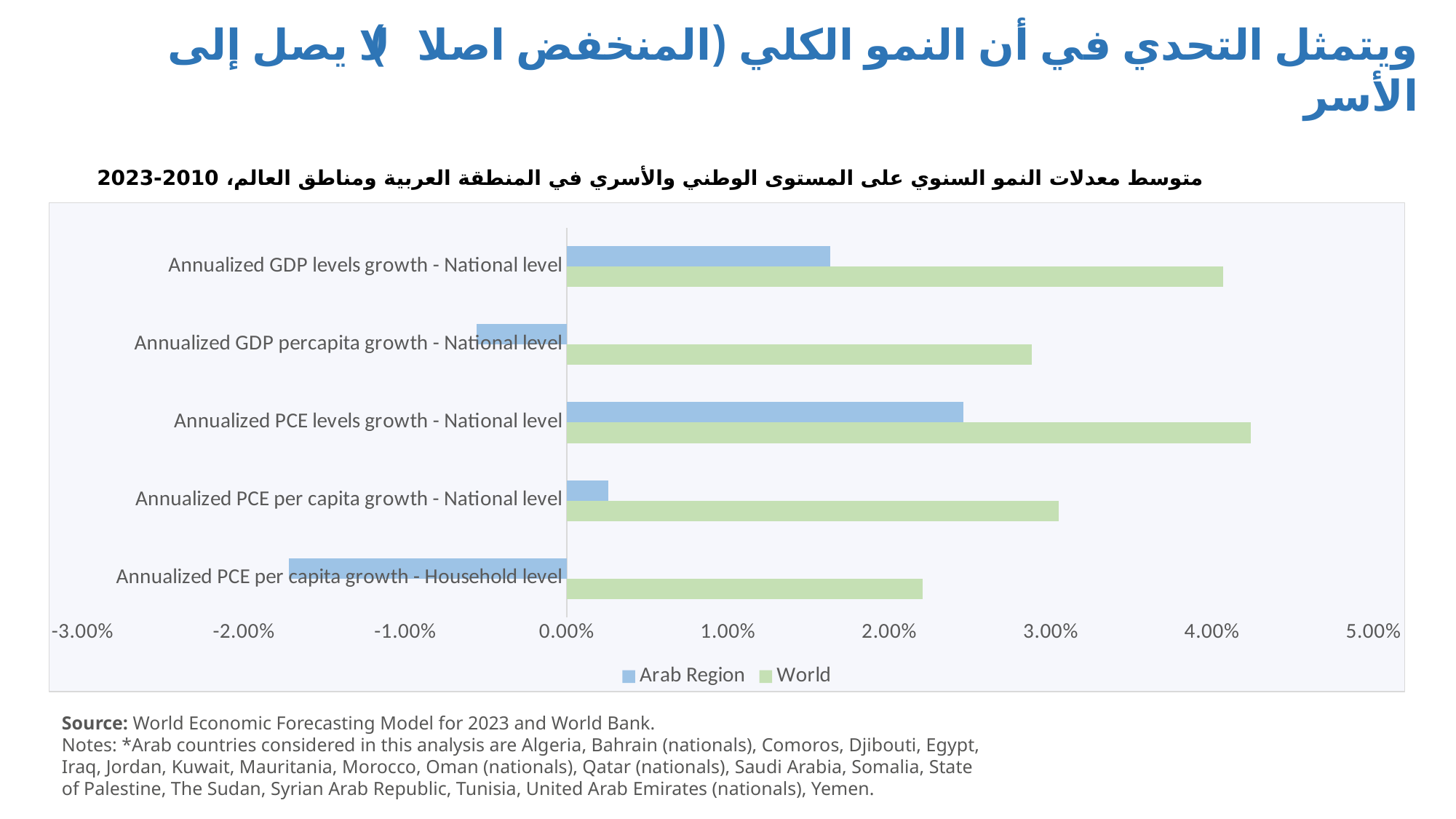
What kind of chart is shown on the slide? Bar chart Is the Arab Region value for Annualized GDP percapita growth - National level greater or less than 0.00%? less For which category is the Arab Region value the lowest? Annualized PCE per capita growth - Household level Is the Arab Region value for Annualized PCE per capita growth - Household level greater or less than -1.00%? less Which series is shown in green in the chart? World How many series does the chart legend list? 2 For Annualized GDP levels growth - National level, which is larger: the Arab Region value or the World value? World How many categories are plotted on the chart? 5 Is the Arab Region value for Annualized GDP levels growth - National level greater or less than 1.00%? greater For which category is the World value the highest? Annualized PCE levels growth - National level For which category is the Arab Region value the highest? Annualized PCE levels growth - National level